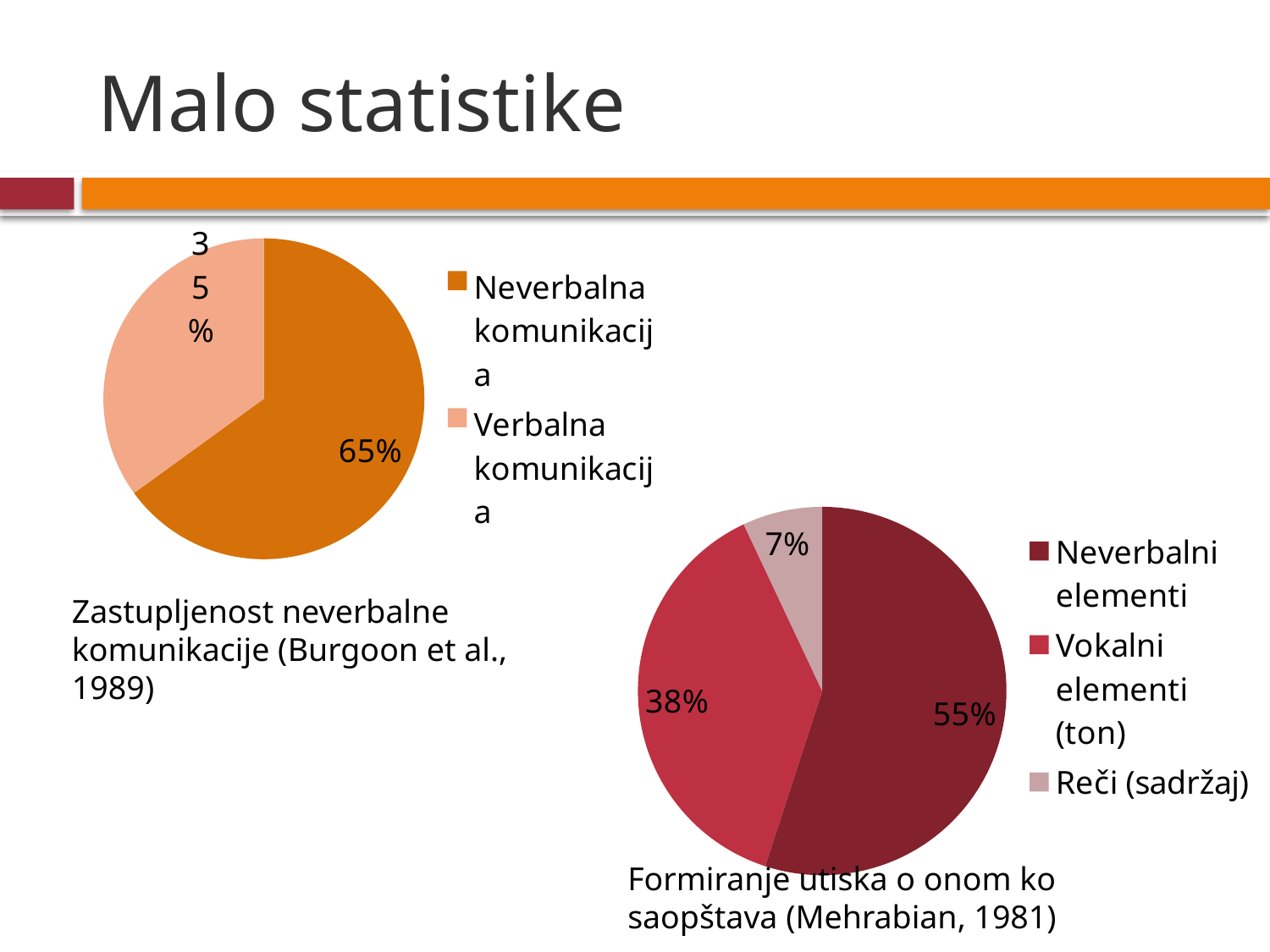
In the lower-right pie chart, what share is shown for Reči (sadržaj)? 7% In the lower-right pie chart, which category has the smallest slice? Reči (sadržaj) In the upper-left pie chart, what is the difference between the Neverbalna komunikacija and Verbalna komunikacija shares? 30% How many slices does the lower-right pie chart have? 3 What kind of chart is the upper-left chart (Zastupljenost neverbalne komunikacije)? pie chart In the upper-left pie chart, what share is shown for Neverbalna komunikacija? 65% In the upper-left pie chart, which slice is larger, Neverbalna komunikacija or Verbalna komunikacija? Neverbalna komunikacija In the lower-right pie chart, what share is shown for Vokalni elementi (ton)? 38% In the lower-right pie chart (Formiranje utiska o onom ko saopštava), what share is shown for Neverbalni elementi? 55% How many entries does the legend of the upper-left pie chart list? 2 In the lower-right pie chart, which category has the largest slice? Neverbalni elementi In the upper-left pie chart, what share is shown for Verbalna komunikacija? 35%